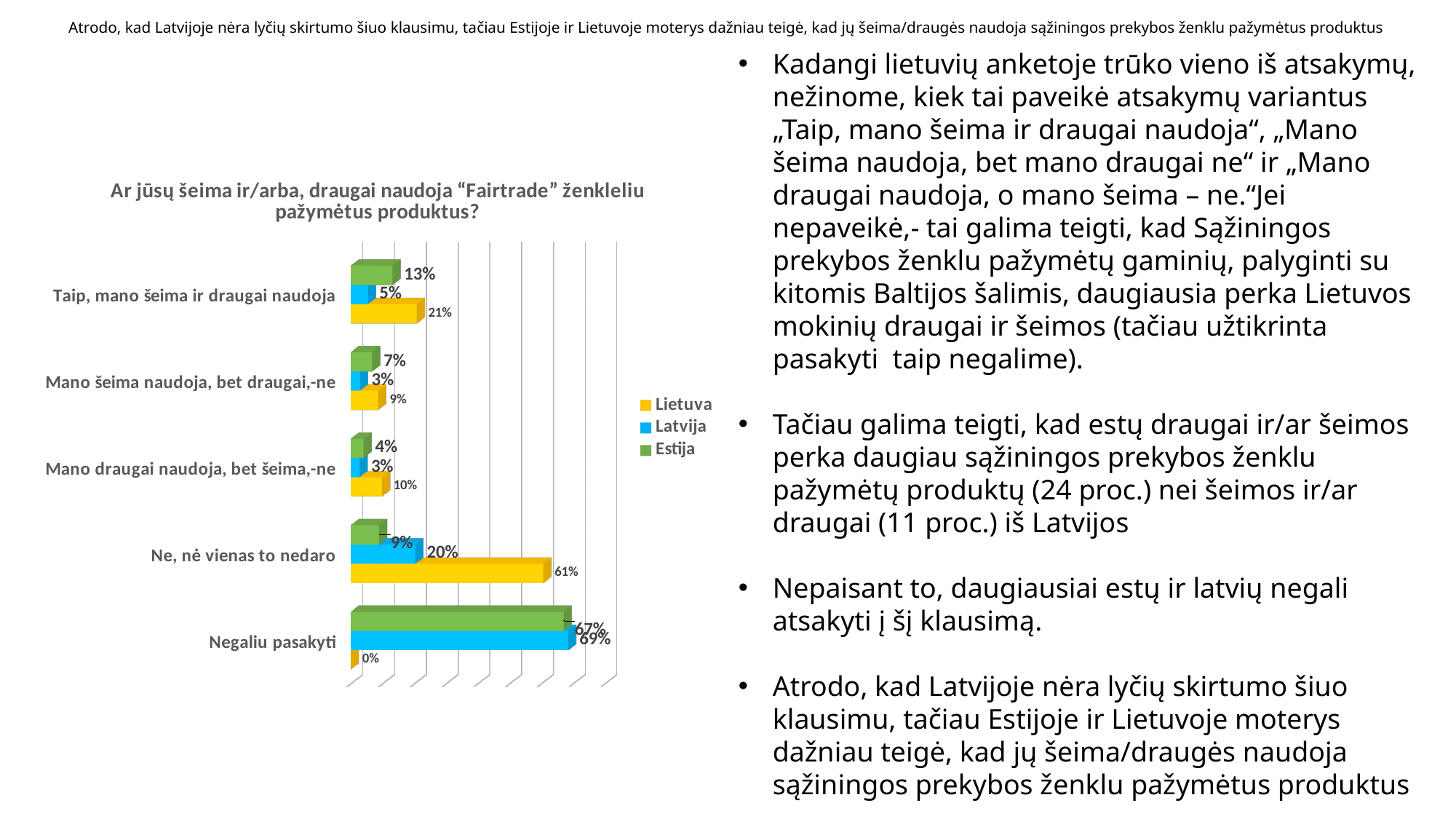
Which category has the lowest value for Estija? Mano draugai naudoja, bet šeima,-ne What is the value for Latvija in the category "Ne, nė vienas to nedaro"? 20% What is the value for Lietuva in the category "Negaliu pasakyti"? 0% How many series does the chart legend list? 3 What is the value for Lietuva in the category "Taip, mano šeima ir draugai naudoja"? 21% What kind of chart is shown on the slide? Bar chart What is the value for Estija in the category "Negaliu pasakyti"? 67% Which category has the highest value for Lietuva? Ne, nė vienas to nedaro Which series is shown in green in the chart legend? Estija In the category "Taip, mano šeima ir draugai naudoja", which is larger: the value for Estija or the value for Latvija? Estija How many categories are shown on the chart? 5 What is the difference between the Lietuva and Latvija values in the category "Ne, nė vienas to nedaro"? 41%